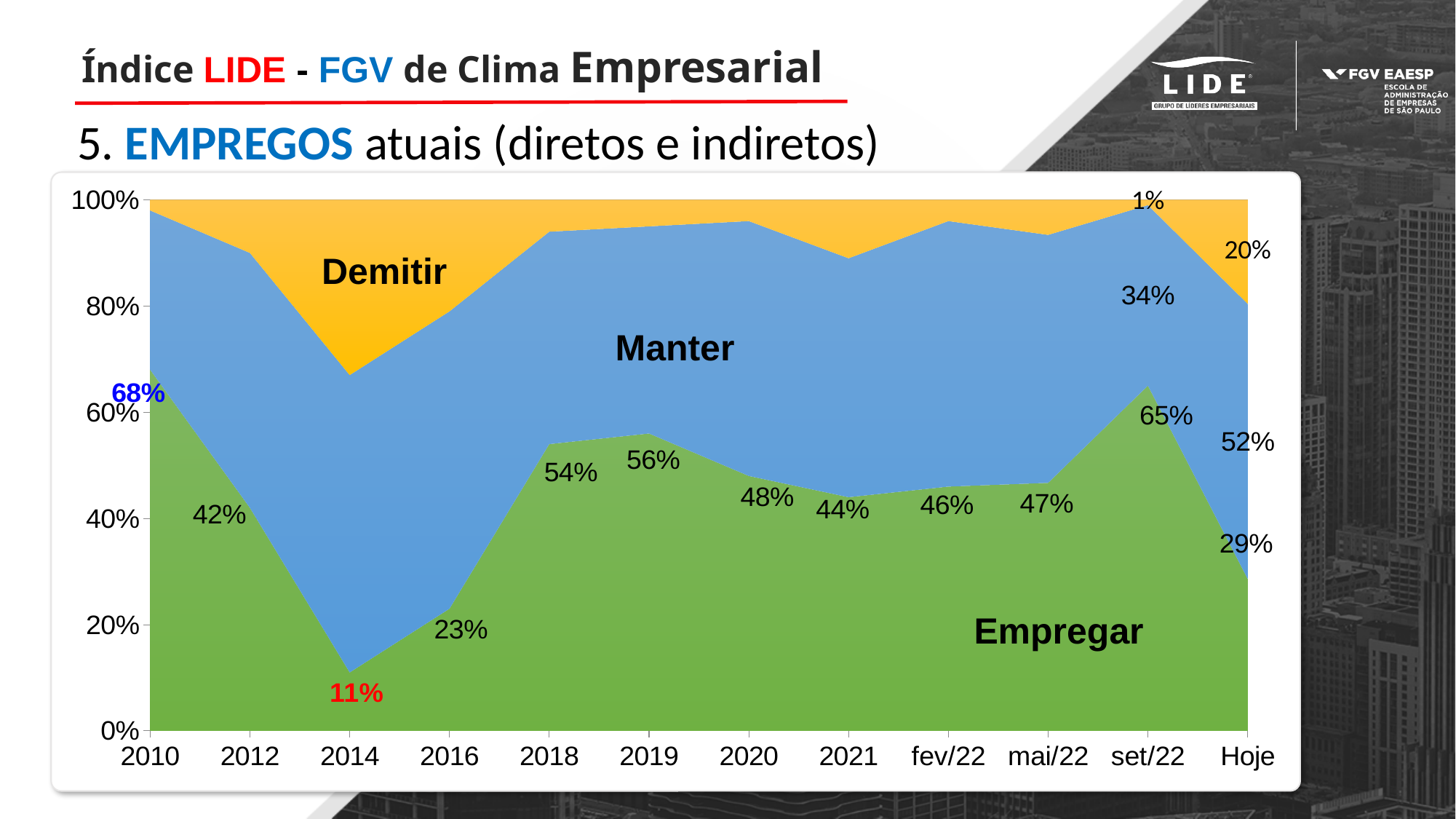
What is the difference between the Empregar value in set/22 and at Hoje? 36% Which is larger, the Empregar value in 2018 or in 2020? 2018 What is the value for Manter in set/22? 34% What is the value for Empregar in 2010? 68% How many series are shown in the chart? 3 What is the value for Demitir at Hoje? 20% What kind of chart is shown on the slide? stacked area chart What is the value for Empregar at Hoje? 29% In which period is the Empregar value highest? 2010 How many time points are shown on the x axis? 12 In which period is the Empregar value lowest? 2014 What is the value for Empregar in 2014? 11%